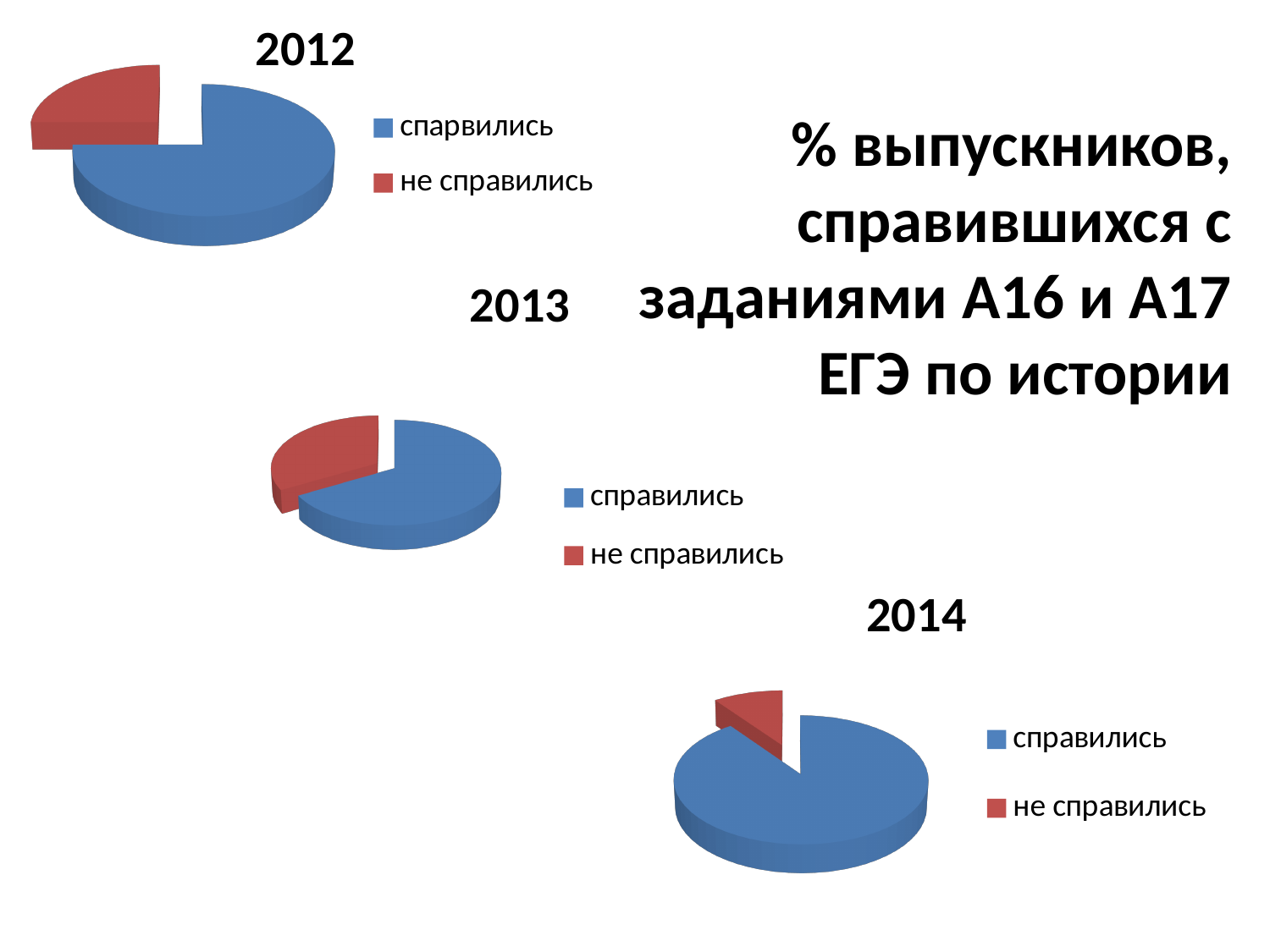
In the chart titled 2013, which category has the largest slice? справились How many entries does the legend of the chart titled 2014 list? 2 How many pie charts are shown on the slide? 3 What kind of chart is the chart titled 2012? pie chart What colour represents не справились in the chart titled 2013? red What is the title of the chart at the bottom right of the slide? 2014 In the chart titled 2014, which category has the smallest slice? не справились In the chart titled 2012, which slice is larger: справились or не справились? справились In the chart titled 2014, which slice is larger: справились or не справились? справились How many slices does the chart titled 2013 have? 2